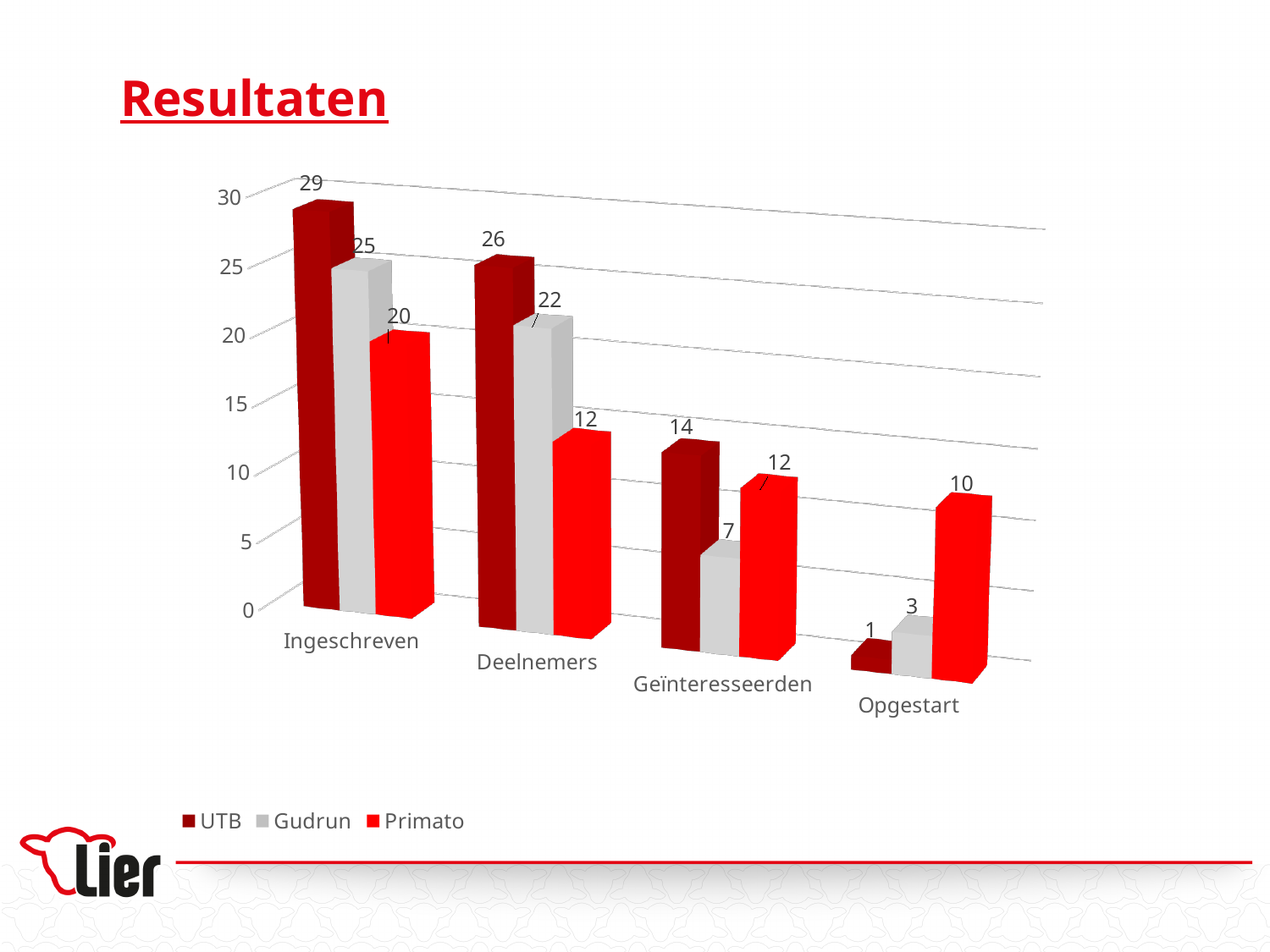
Which series has the highest value in the Geïnteresseerden category? UTB What is the value for Gudrun in the Deelnemers category? 22 What is the value for Primato in the Opgestart category? 10 What is the title of the slide containing the chart? Resultaten What is the value for UTB in the Ingeschreven category? 29 How many series does the legend list? 3 Do the UTB values rise or fall from Ingeschreven to Opgestart? fall Which is larger: the Gudrun value for Geïnteresseerden or the Primato value for Geïnteresseerden? Primato What is the difference between the UTB and Primato values in the Deelnemers category? 14 How many categories are shown on the x axis? 4 What kind of chart is shown on the slide? bar chart Which series has the lowest value in the Opgestart category? UTB